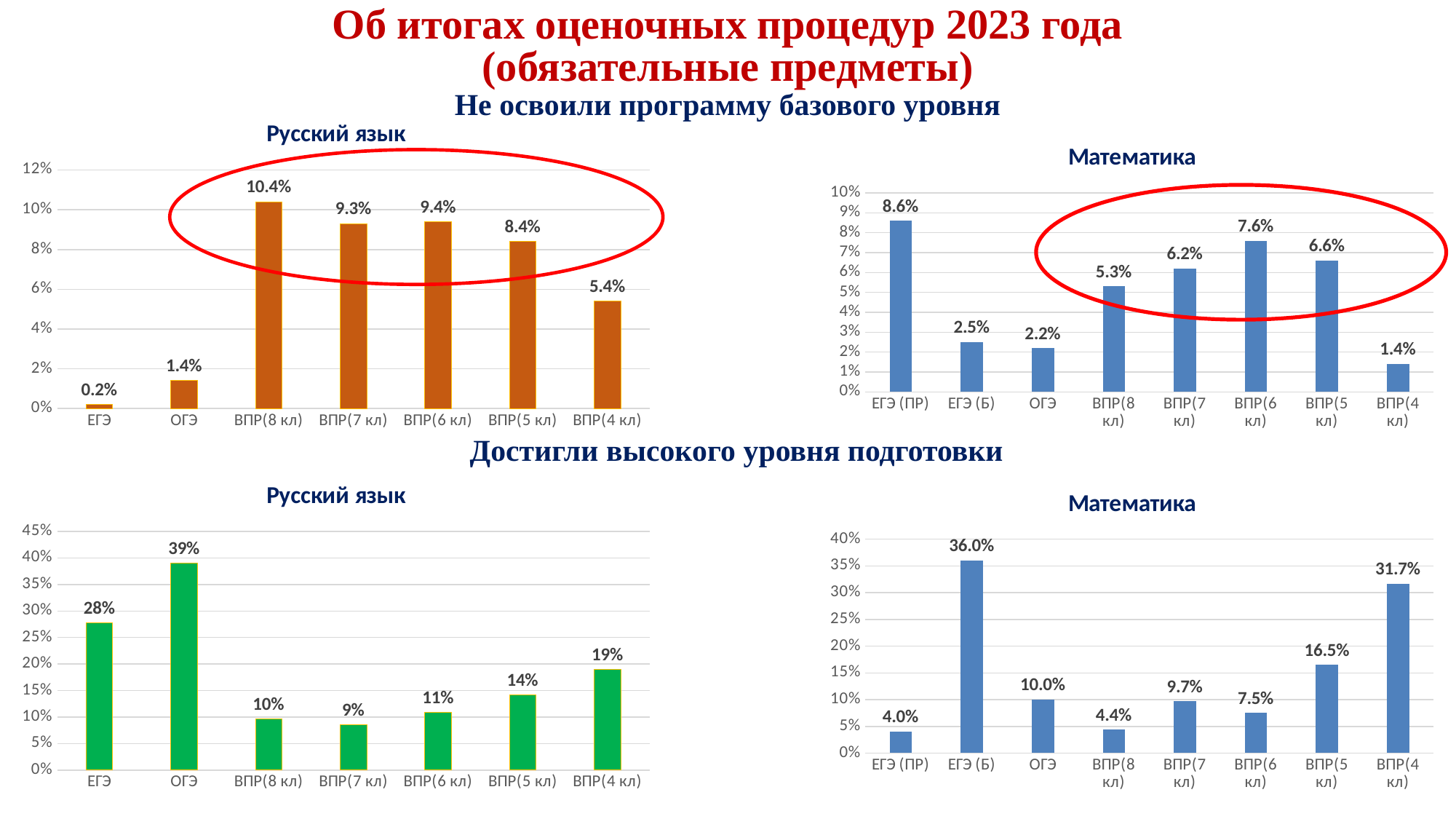
In the bottom-right chart (Математика, Достигли высокого уровня подготовки), which category has the highest value? ЕГЭ (Б) In the top-right chart (Математика, Не освоили программу базового уровня), what is the difference between ВПР(6 кл) and ВПР(8 кл)? 2.3% In the bottom-left chart (Русский язык, Достигли высокого уровня подготовки), how many categories are shown? 7 In the top-left chart (Русский язык, Не освоили программу базового уровня), what is the value for ВПР(8 кл)? 10.4% In the top-right chart (Математика, Не освоили программу базового уровня), what is the value for ЕГЭ (ПР)? 8.6% In the bottom-right chart (Математика, Достигли высокого уровня подготовки), how many categories are shown? 8 What type of chart is the top-left chart (Русский язык, Не освоили программу базового уровня)? Bar chart In the bottom-left chart (Русский язык, Достигли высокого уровня подготовки), which is larger: ЕГЭ or ВПР(4 кл)? ЕГЭ In the top-left chart (Русский язык, Не освоили программу базового уровня), which category has the lowest value? ЕГЭ In the bottom-right chart (Математика, Достигли высокого уровня подготовки), what is the value for ВПР(5 кл)? 16.5% In the bottom-left chart (Русский язык, Достигли высокого уровня подготовки), what is the value for ОГЭ? 39% In the top-right chart (Математика, Не освоили программу базового уровня), which category has the highest value? ЕГЭ (ПР)